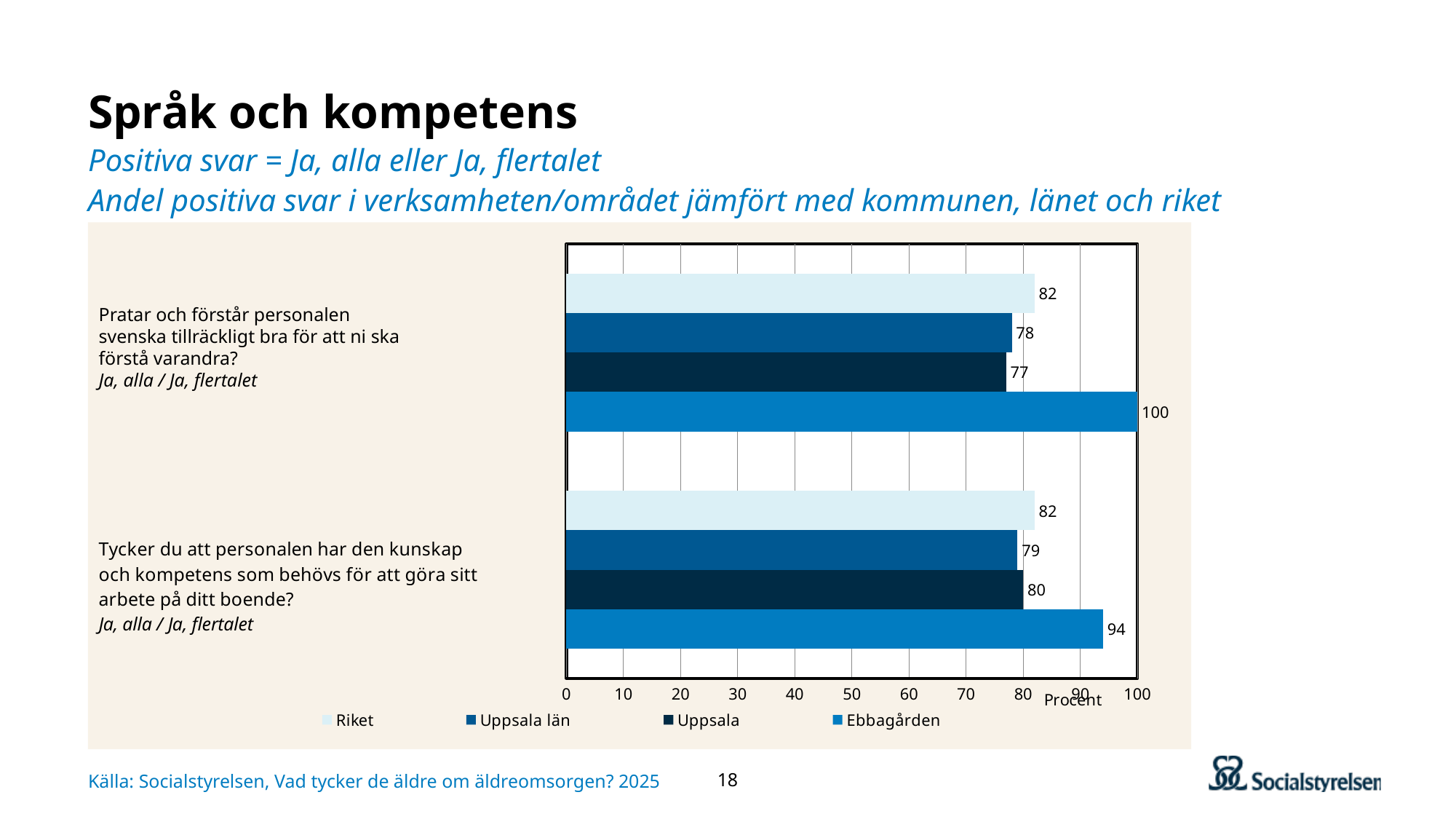
What is the difference between Ebbagården and Uppsala on the question about whether staff have the knowledge and competence needed? 14 What unit is shown on the x axis of the chart? Procent What is the value for Uppsala on the question about whether staff speak and understand Swedish well enough? 77 Which is larger: Ebbagården's value on the Swedish-language question or Ebbagården's value on the knowledge and competence question? The Swedish-language question Which series has the lowest value on the question about whether staff speak and understand Swedish well enough? Uppsala What is the value for Uppsala län on the question about whether staff have the knowledge and competence needed? 79 How many series does the legend list? 4 Which series has the highest value on the question about whether staff have the knowledge and competence needed? Ebbagården What is the value for Ebbagården on the question about whether staff speak and understand Swedish well enough? 100 What kind of chart is shown on the slide? Bar chart What is the difference between Ebbagården and Riket on the question about whether staff speak and understand Swedish well enough? 18 What is the value for Riket on the question about whether staff have the knowledge and competence needed? 82